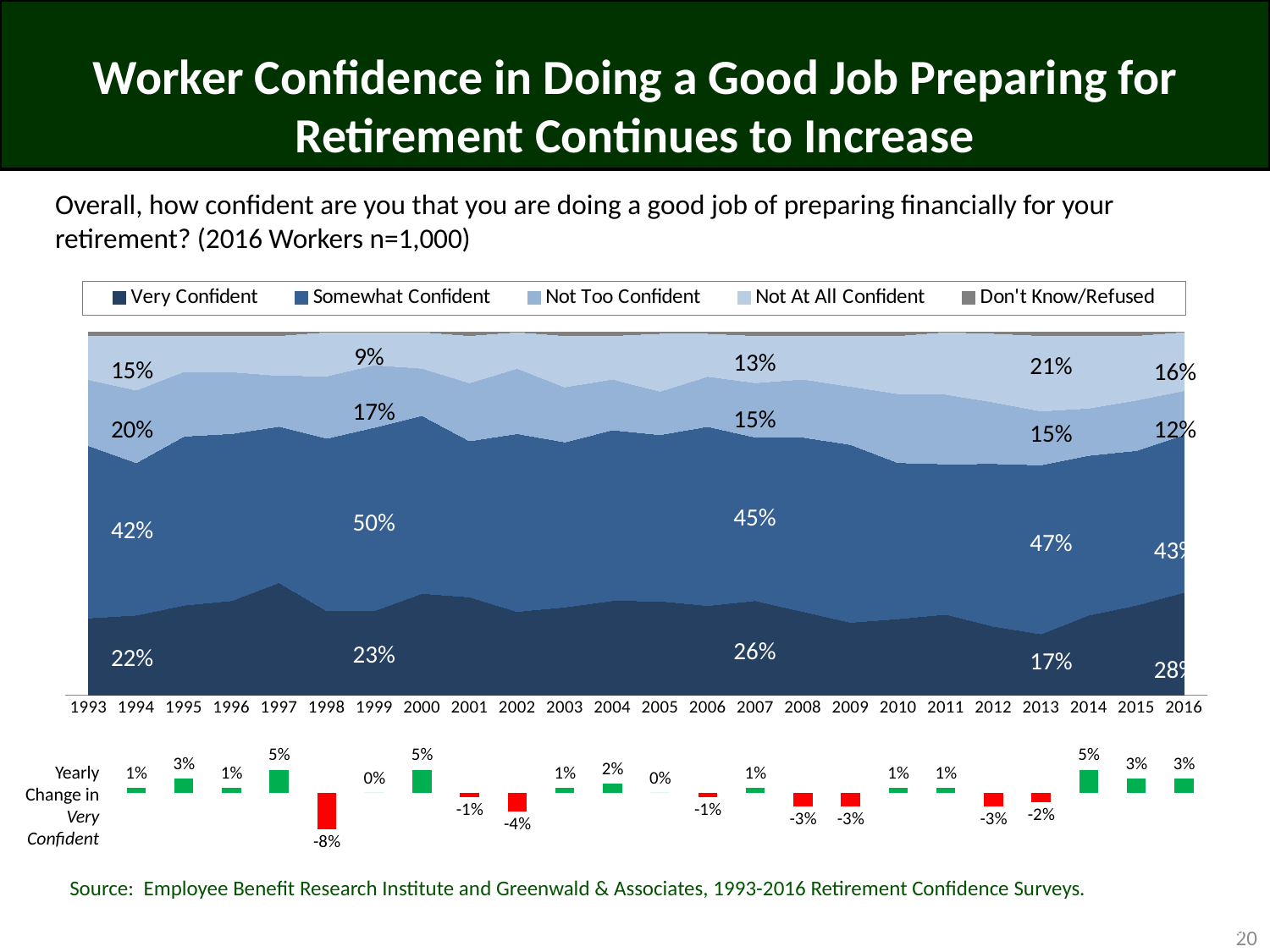
How many series does the legend of the stacked area chart list? 5 In the stacked area chart, which is larger: the Very Confident share in 2007 or the Very Confident share in 2013? 2007 In the stacked area chart, what percentage of workers were Not At All Confident in 2013? 21% What is the first year shown on the x axis of the stacked area chart? 1993 In the Yearly Change in Very Confident bar chart, which year has the lowest value? 1998 In the Yearly Change in Very Confident bar chart, what is the value for 2014? 5% In the Yearly Change in Very Confident bar chart, what is the value for 1998? -8% What kind of chart is the lower chart showing Yearly Change in Very Confident? bar chart In the stacked area chart, what percentage of workers were Not Too Confident in 2016? 12%